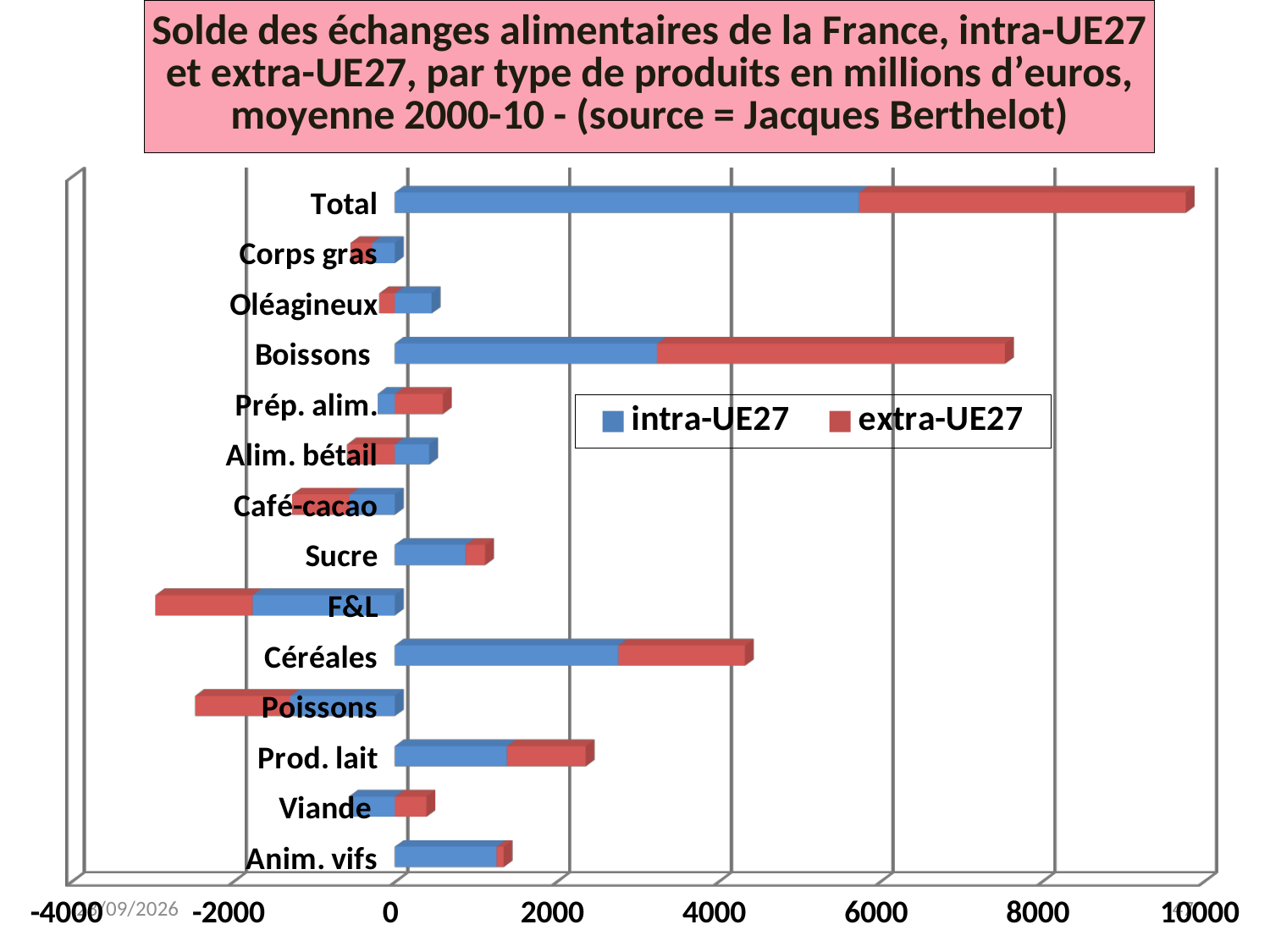
Is the extra-UE27 value for Poissons greater or less than -2000? greater Is the extra-UE27 value for F&L greater or less than 0? less Excluding Total, which product category has the largest positive balance? Boissons Is the intra-UE27 value for Boissons greater or less than 2000? greater What kind of chart is shown on the slide? bar chart Which is larger, the intra-UE27 value for Boissons or the intra-UE27 value for Céréales? Boissons Which category has the longest total bar? Total Which colour represents the extra-UE27 series in the legend? red How many series does the legend list? 2 How many categories are plotted on the chart? 14